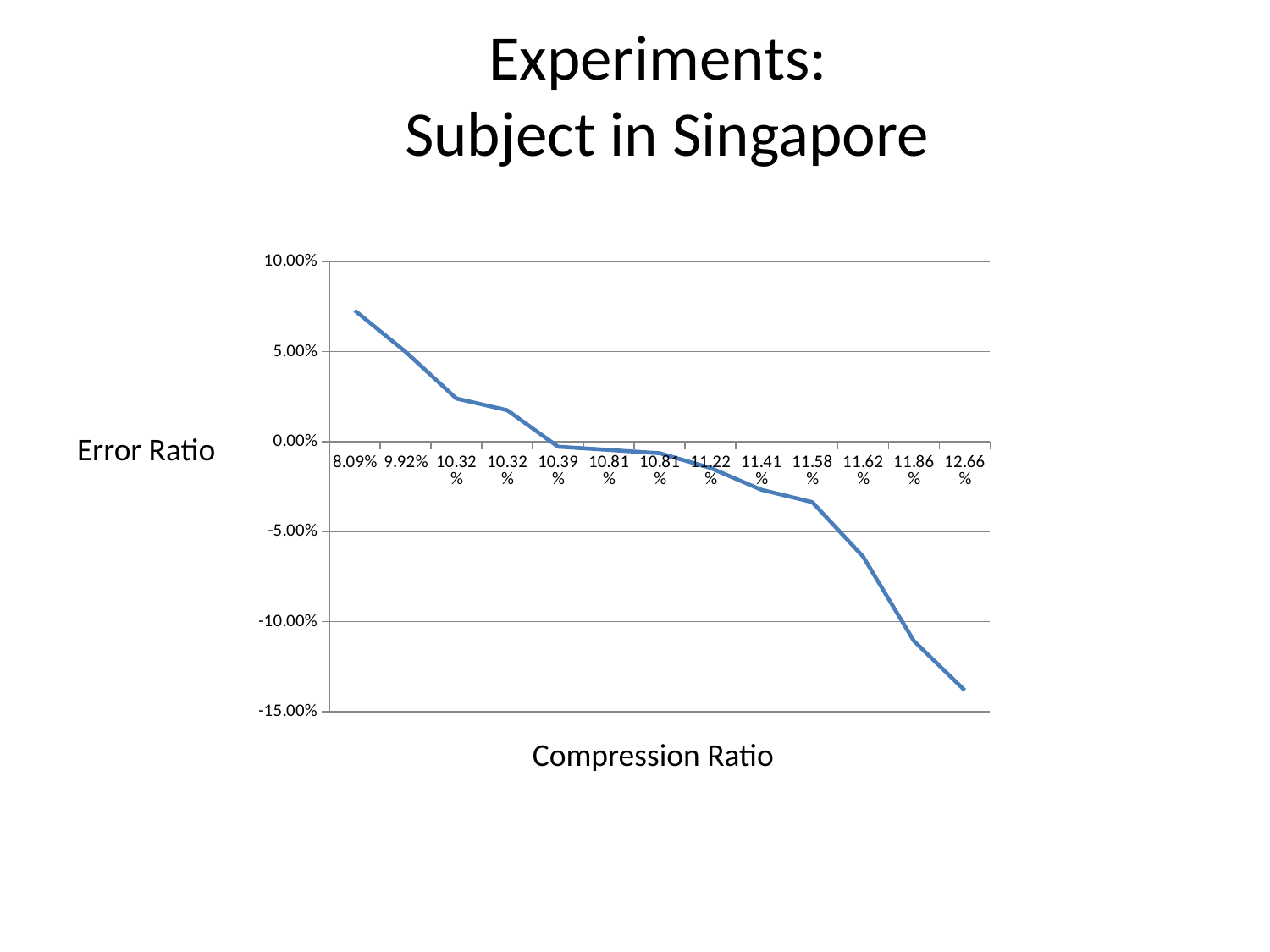
Which has the larger error ratio: a compression ratio of 9.92% or 11.86%? 9.92% At which compression ratio is the error ratio highest? 8.09% What kind of chart is shown on the slide? line chart What is the label on the y axis of the chart? Error Ratio What is the label on the x axis of the chart? Compression Ratio At which compression ratio is the error ratio lowest? 12.66% Is the error ratio at a compression ratio of 11.58% greater or less than -5.00%? greater Do the error ratio values rise or fall as the compression ratio increases along the x axis? fall Is the error ratio at a compression ratio of 12.66% greater or less than -10.00%? less Is the error ratio at a compression ratio of 11.62% greater or less than -5.00%? less How many data points are plotted on the line? 13